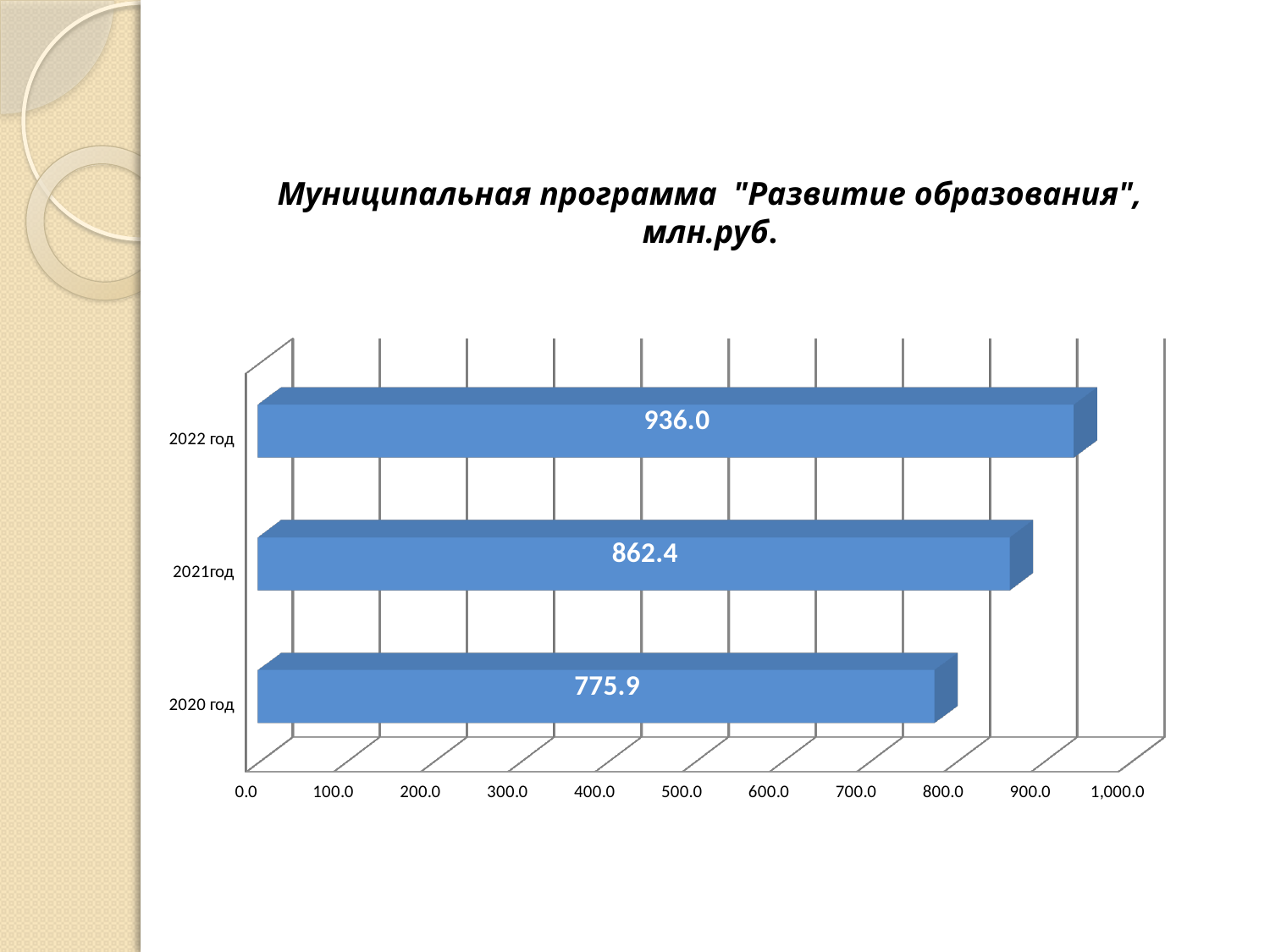
Which is larger, the value for 2021год or the value for 2020 год? 2021год What is the title of the chart? Муниципальная программа "Развитие образования", млн.руб. Which year has the lowest value? 2020 год What is the difference between the values for 2022 год and 2020 год? 160.1 What is the value for 2020 год? 775.9 Which year has the highest value? 2022 год What is the value for 2021год? 862.4 What kind of chart is shown on the slide? bar chart What is the difference between the values for 2021год and 2020 год? 86.5 What is the value for 2022 год? 936.0 Is the value for 2022 год greater or less than 900.0? greater How many years are shown in the chart? 3